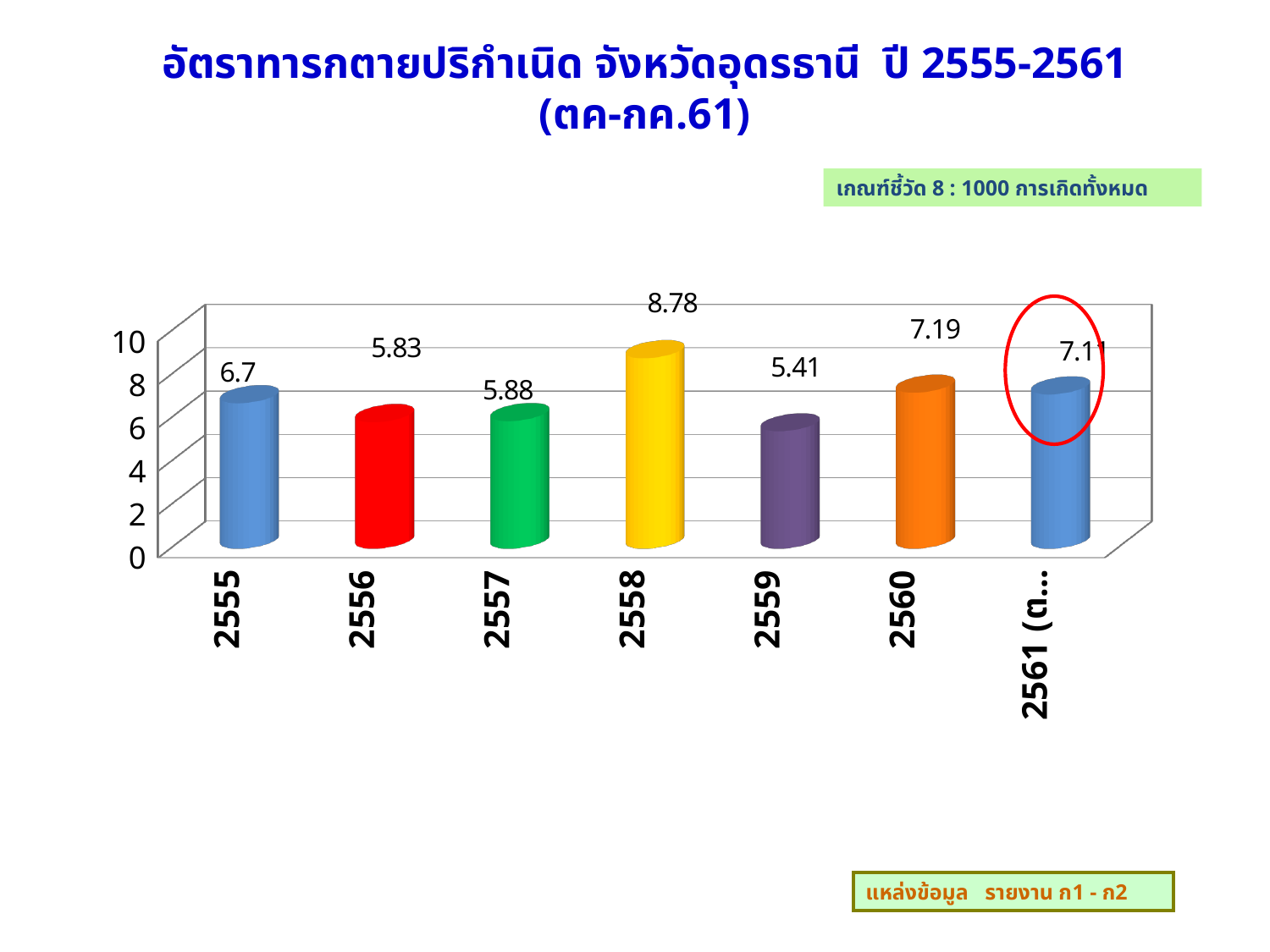
How many years are shown on the x axis? 7 Which year has the lowest value? 2559 Which is larger, the value for 2555 or the value for 2556? 2555 What kind of chart is shown on the slide? bar chart What is the difference between the values for 2560 and 2561? 0.08 What is the value for 2560? 7.19 Which year has the highest value? 2558 Is the value for 2558 greater or less than 8? greater What is the value for 2558? 8.78 What is the difference between the values for 2558 and 2559? 3.37 What is the value for 2559? 5.41 What is the value for 2555? 6.7